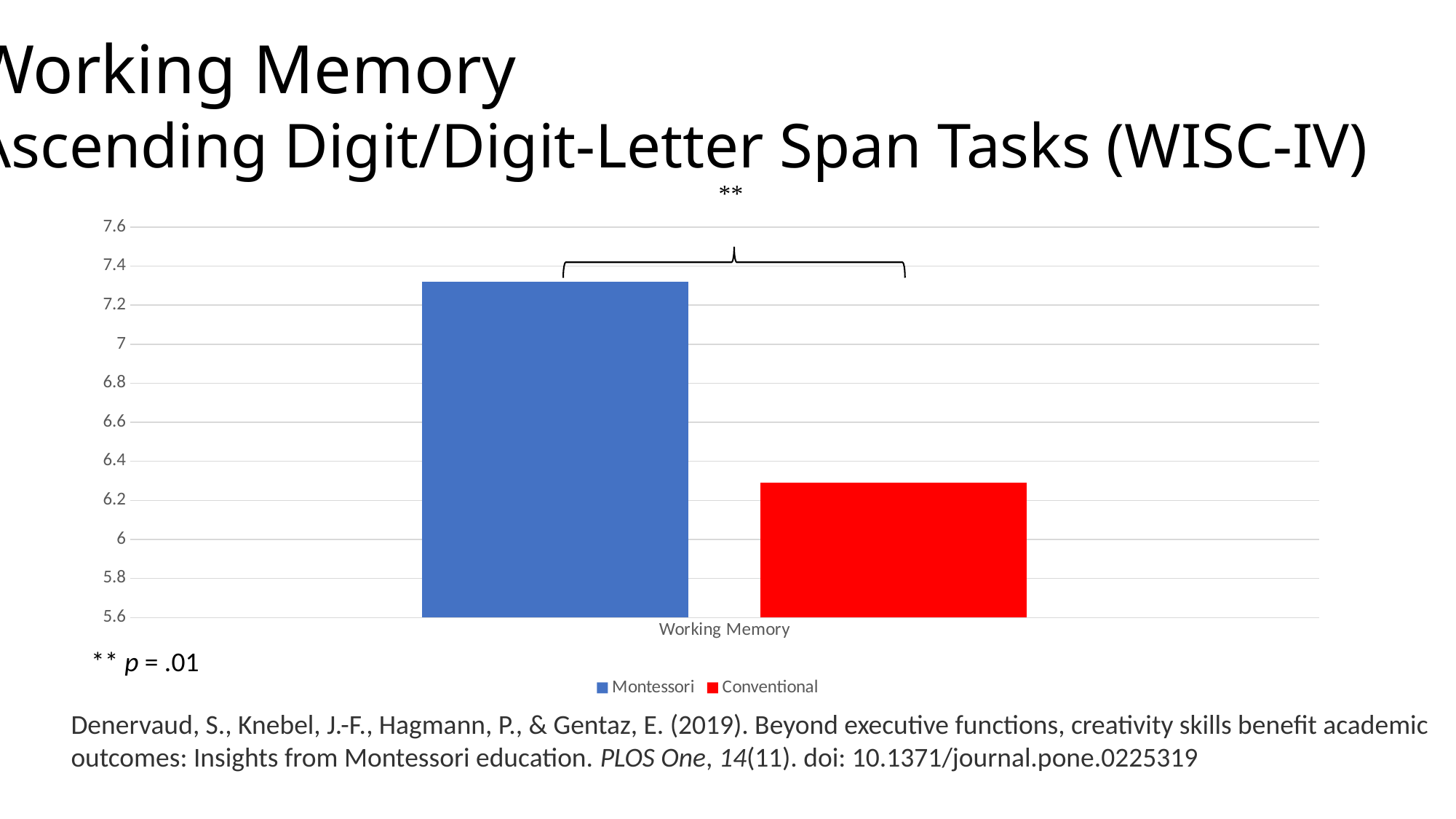
How many series does the legend list? 2 What colour is the Conventional series in the chart? red Which series has the higher Working Memory score, Montessori or Conventional? Montessori How many categories are shown on the x axis? 1 Which series has the lowest bar in the chart? Conventional What is the category label shown on the x axis of the chart? Working Memory What kind of chart is shown on the slide? bar chart Is the value for Montessori greater or less than 7.2? greater Is the value for Montessori greater or less than 7.4? less Which series has the highest bar in the chart? Montessori Is the value for Conventional greater or less than 6? greater